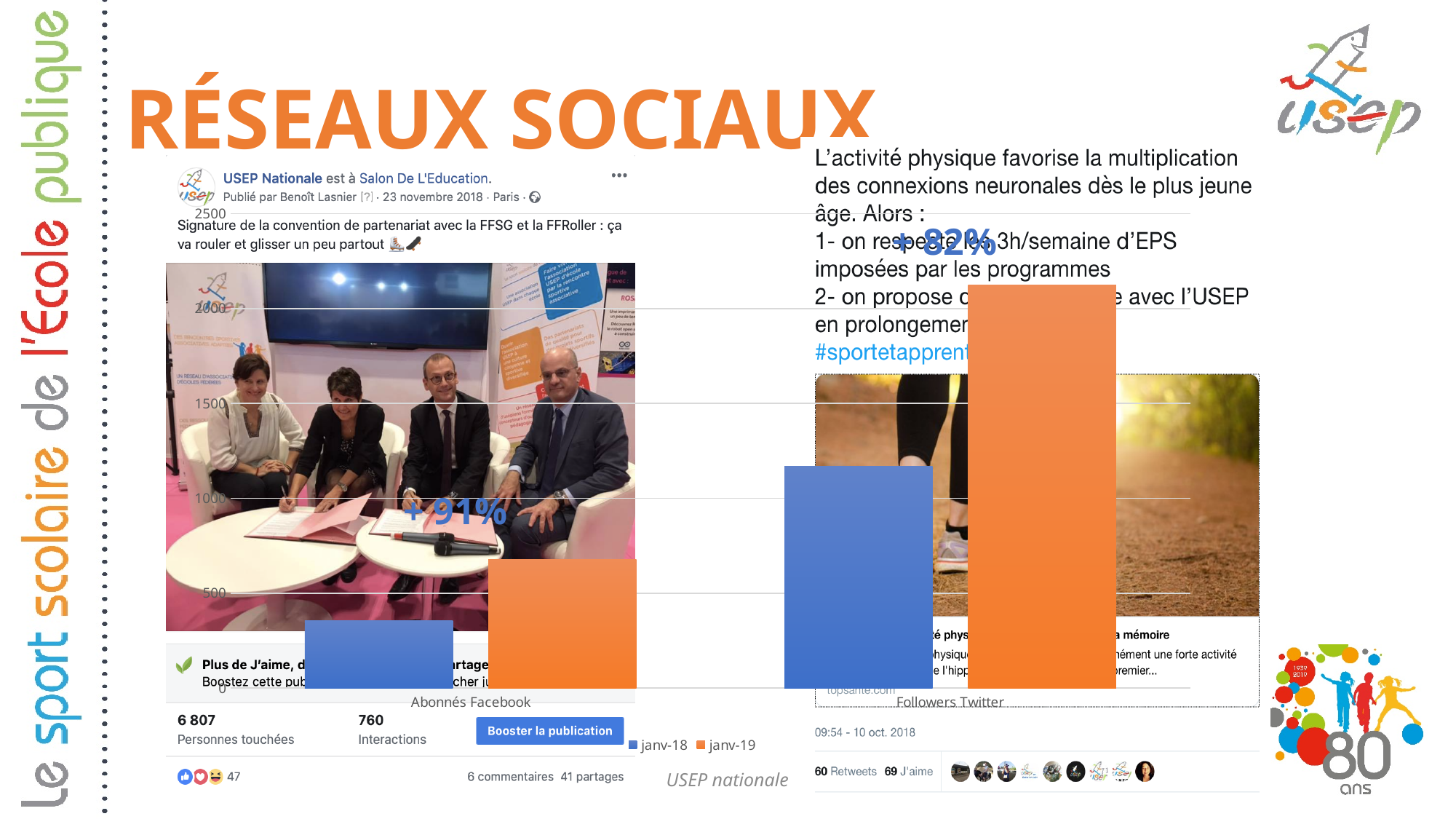
Is the janv-18 value for Abonnés Facebook greater or less than 500? less Is the janv-18 value for Followers Twitter greater or less than 1500? less For Followers Twitter, which series has the larger value, janv-18 or janv-19? janv-19 How many series does the chart legend list? 2 Which bar is the lowest in the chart? Abonnés Facebook, janv-18 What kind of chart is shown on the slide? bar chart How many categories are shown on the x axis of the chart? 2 Is the janv-19 value for Followers Twitter greater or less than 2000? greater What percentage increase is annotated above the Abonnés Facebook bars? + 91% Which two series are listed in the chart legend? janv-18 and janv-19 Which category has the tallest bar in the chart? Followers Twitter